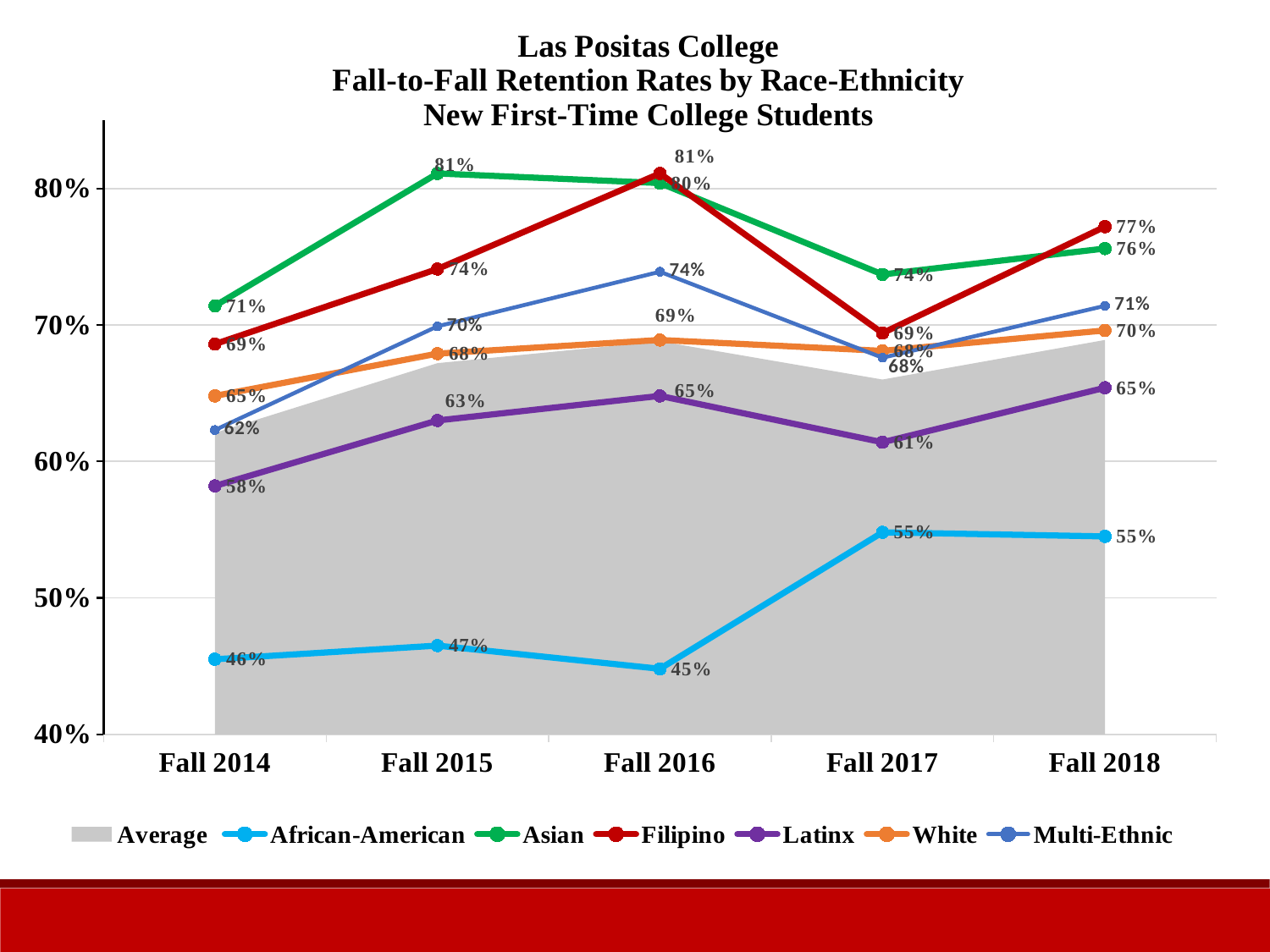
Does the African-American retention rate rise or fall from Fall 2014 to Fall 2018? rise How many terms are shown on the x axis? 5 In which term is the Asian retention rate highest? Fall 2015 Which is higher in Fall 2016, the Filipino rate or the Multi-Ethnic rate? Filipino Is the Average value for Fall 2018 greater or less than 60%? greater What is the retention rate for Filipino students in Fall 2018? 77% What is the difference between the Asian and African-American retention rates in Fall 2015? 34 percentage points In which term is the African-American retention rate lowest? Fall 2016 What kind of chart is this? combination area and line chart What is the retention rate for Latinx students in Fall 2014? 58% How many series does the legend list? 7 What is the retention rate for African-American students in Fall 2016? 45%